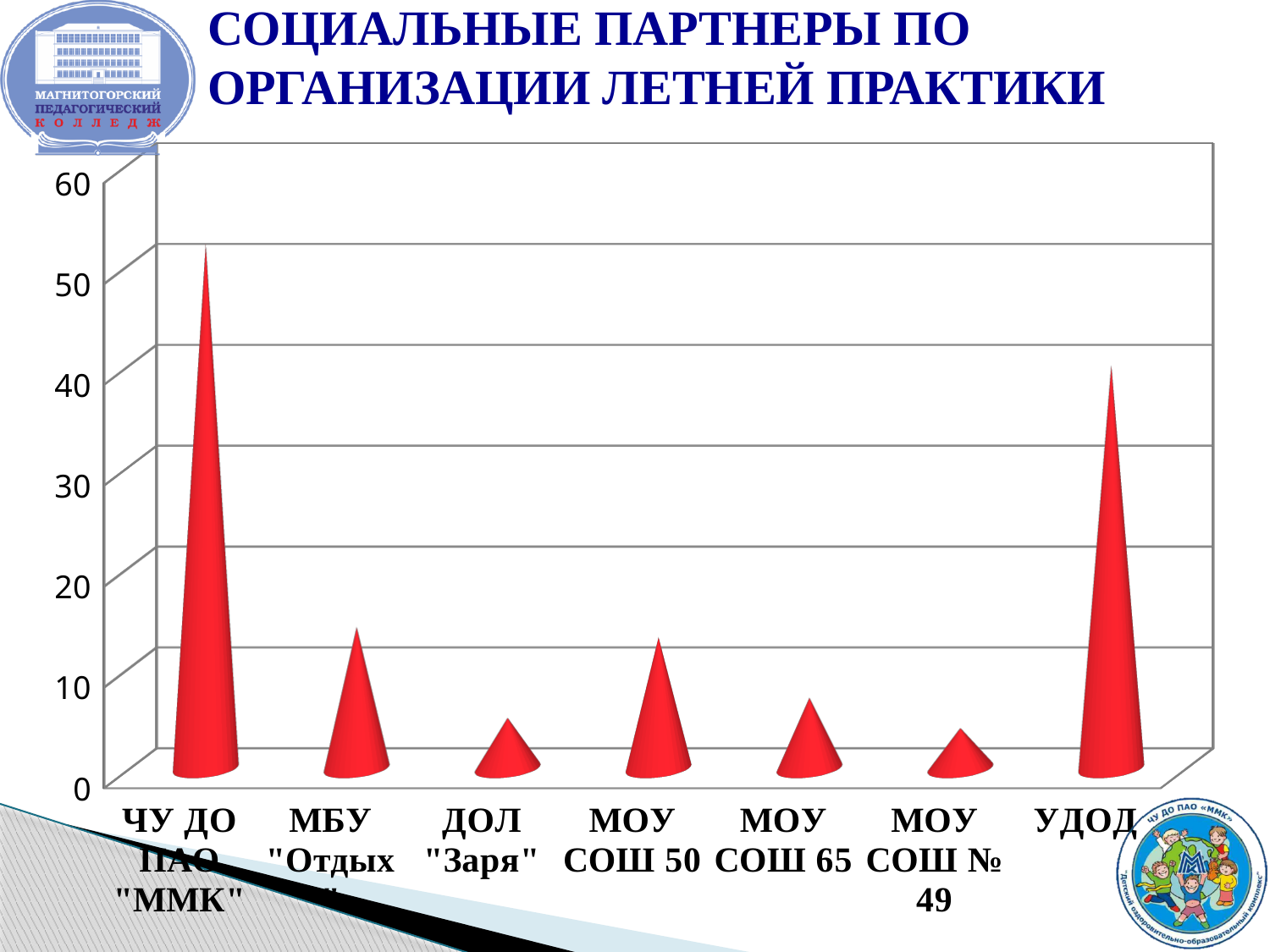
What kind of chart is shown on the slide? bar chart Which has the larger value, МОУ СОШ 50 or МОУ СОШ 65? МОУ СОШ 50 Is the value for ДОЛ "Заря" greater or less than 10? less Is the value for МОУ СОШ 50 greater or less than 20? less How many categories (social partners) are shown on the x axis of the chart? 7 Is the value for ЧУ ДО ПАО "ММК" greater or less than 40? greater Which has the larger value, УДОД or МОУ СОШ 65? УДОД Which category has the highest value in the chart? ЧУ ДО ПАО "ММК" What colour are the bars (cones) in the chart? red What is the title of the slide containing the chart? СОЦИАЛЬНЫЕ ПАРТНЕРЫ ПО ОРГАНИЗАЦИИ ЛЕТНЕЙ ПРАКТИКИ